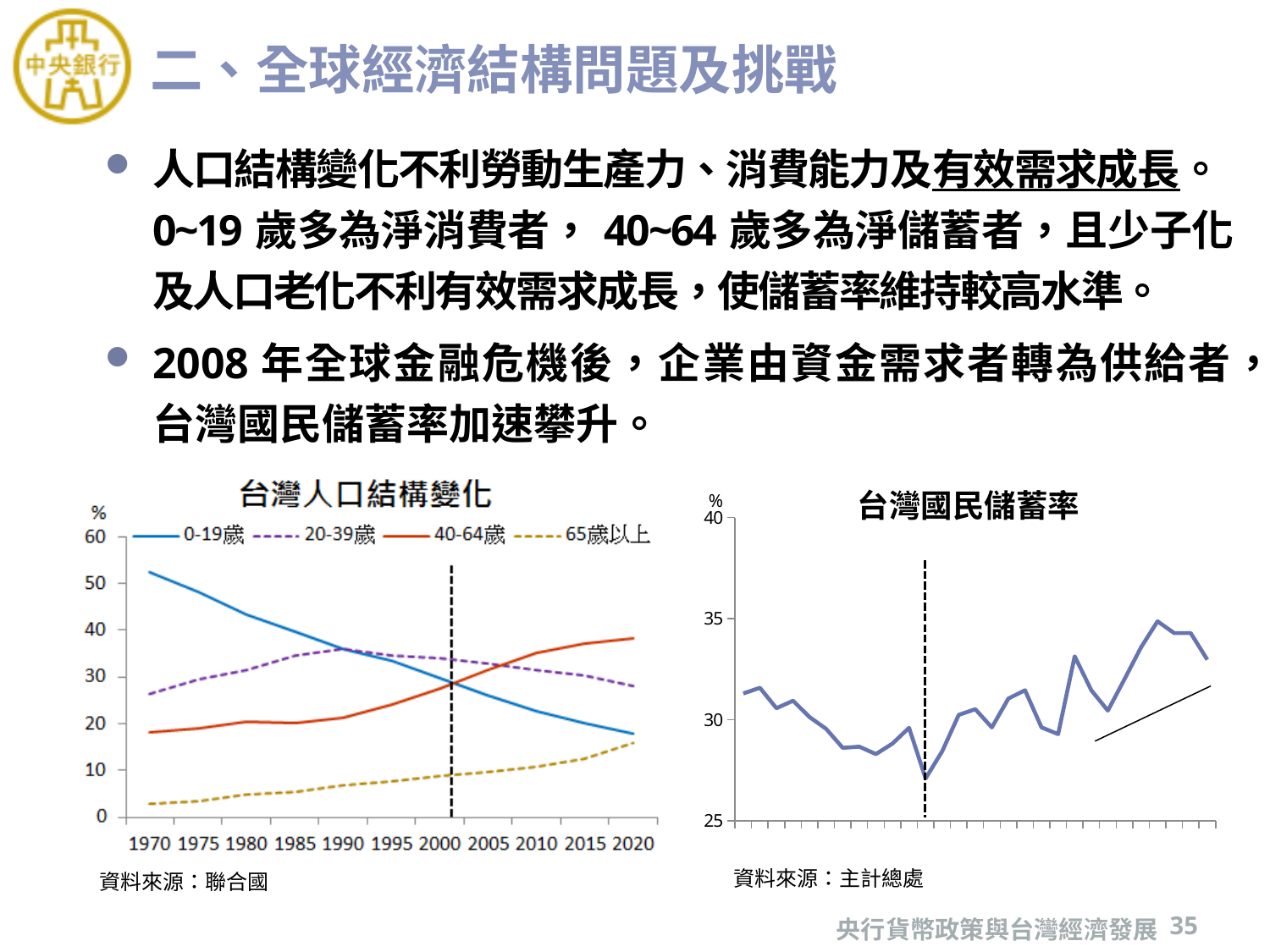
What kind of chart is the 台灣國民儲蓄率 chart on the right? line chart In the 台灣人口結構變化 chart, which is larger in 1970: 0-19歲 or 40-64歲? 0-19歲 In the 台灣人口結構變化 chart, does the 0-19歲 series rise or fall from 1970 to 2020? fall In the 台灣人口結構變化 chart, is the value for 0-19歲 in 1970 greater or less than 40? greater In the 台灣人口結構變化 chart, does the 65歲以上 series rise or fall from 1970 to 2020? rise In the 台灣人口結構變化 chart, which series has the highest value in 2020? 40-64歲 In the 台灣人口結構變化 chart, is the value for 40-64歲 in 2020 greater or less than 30? greater In the 台灣人口結構變化 chart, is the value for 65歲以上 in 1970 greater or less than 10? less In the 台灣人口結構變化 chart, which series has the lowest value in 1970? 65歲以上 How many series does the legend of the 台灣人口結構變化 chart list? 4 What kind of chart is the 台灣人口結構變化 chart on the left? line chart